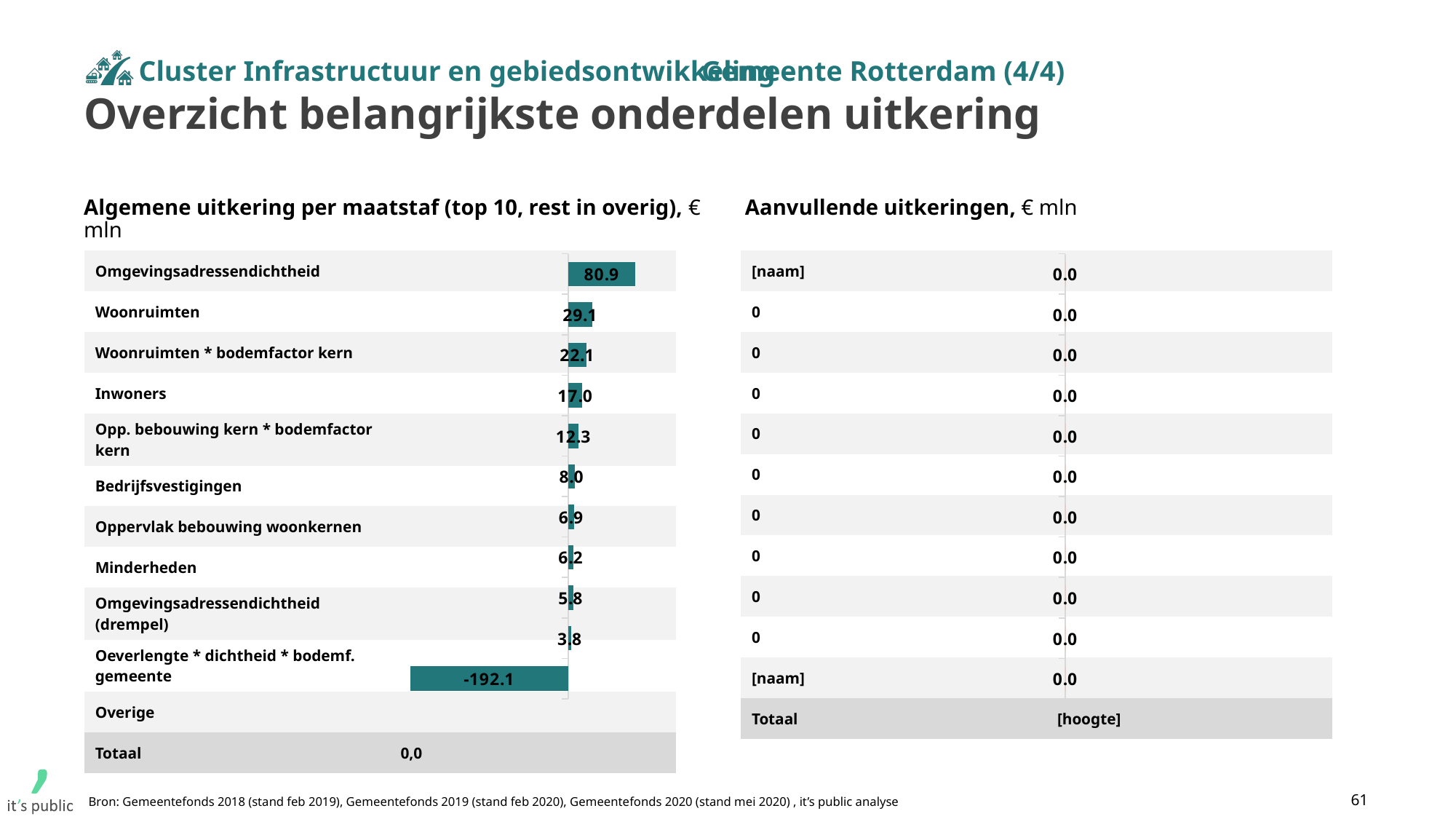
What kind of chart is 'Algemene uitkering per maatstaf'? Bar chart How many categories (excluding the Totaal row) are shown in the chart 'Algemene uitkering per maatstaf'? 11 What is the title of the chart on the right side of the slide? Aanvullende uitkeringen, € mln In the chart 'Algemene uitkering per maatstaf', which category has the lowest value? Overige In the chart 'Aanvullende uitkeringen', what value is shown for each row? 0.0 In the chart 'Algemene uitkering per maatstaf', which is larger: the value for Bedrijfsvestigingen or the value for Minderheden? Bedrijfsvestigingen In the chart 'Algemene uitkering per maatstaf', what is the value for Overige? -192.1 In the chart 'Algemene uitkering per maatstaf', what is the value for Omgevingsadressendichtheid? 80.9 In the chart 'Algemene uitkering per maatstaf', which category has the highest value? Omgevingsadressendichtheid In the chart 'Algemene uitkering per maatstaf', what is the value for Woonruimten? 29.1 In the chart 'Algemene uitkering per maatstaf', what is the difference between the values for Omgevingsadressendichtheid and Woonruimten? 51.8 In the chart 'Algemene uitkering per maatstaf', what is the value for Inwoners? 17.0